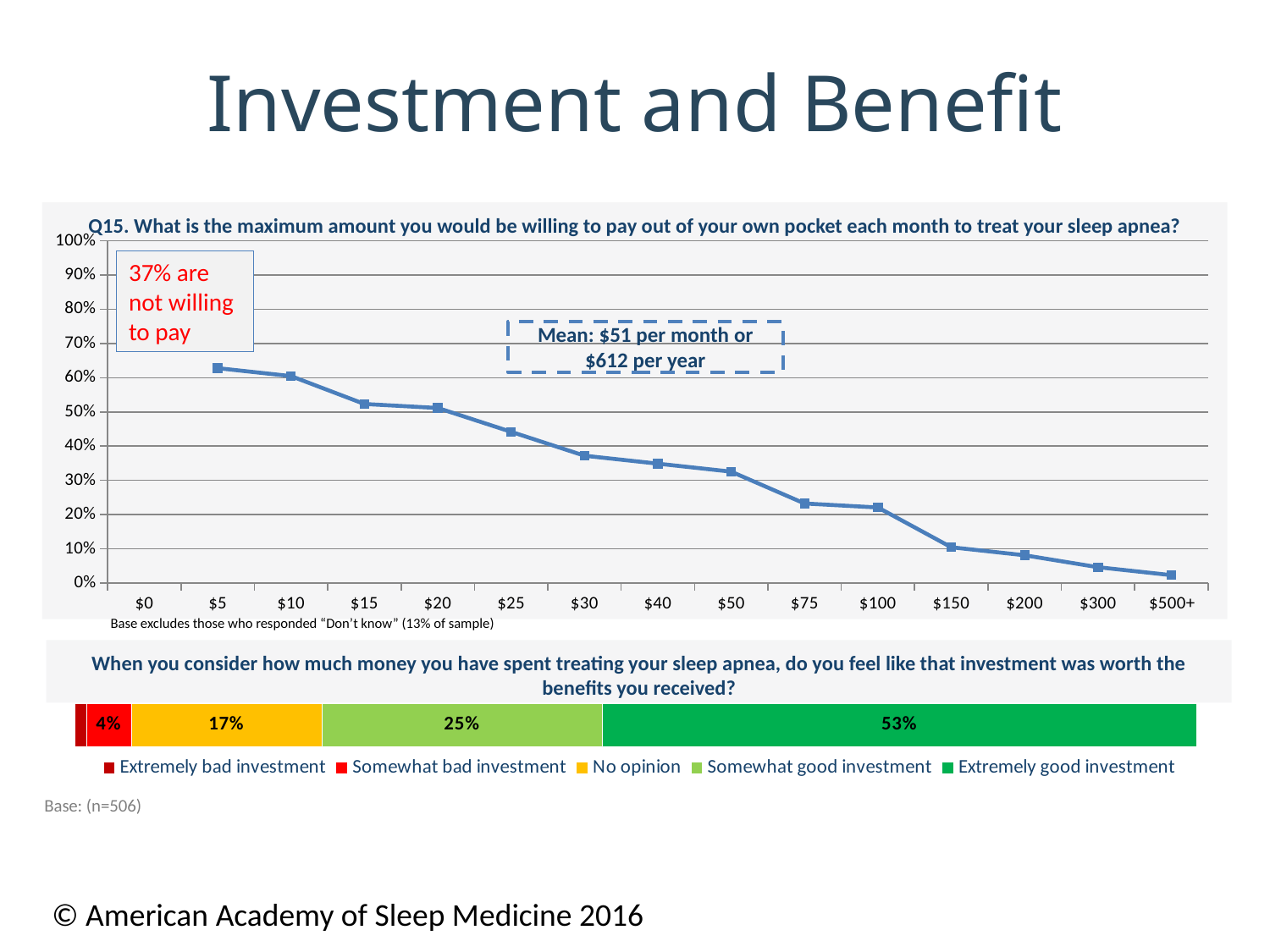
How many series does the legend of the bottom stacked bar chart list? 5 In the bottom stacked bar chart, what percentage had no opinion? 17% In the Q15 line chart, is the value for $5 greater or less than 60%? greater How many categories are shown on the x axis of the Q15 line chart? 15 In the bottom stacked bar chart, which response category has the largest share? Extremely good investment According to the annotation on the Q15 line chart, what is the mean amount per month respondents are willing to pay? $51 per month In the Q15 line chart, do the values rise or fall as the dollar amount increases along the x axis? Fall In the bottom stacked bar chart, what percentage said it was a somewhat bad investment? 4% What kind of chart is the Q15 chart about the maximum amount willing to pay per month? Line chart In the bottom stacked bar chart about whether the investment was worth the benefits, what percentage said it was an extremely good investment? 53% In the bottom stacked bar chart, what percentage said it was a somewhat good investment? 25% In the bottom stacked bar chart, how much larger is the 'Extremely good investment' share than the 'Somewhat good investment' share? 28%